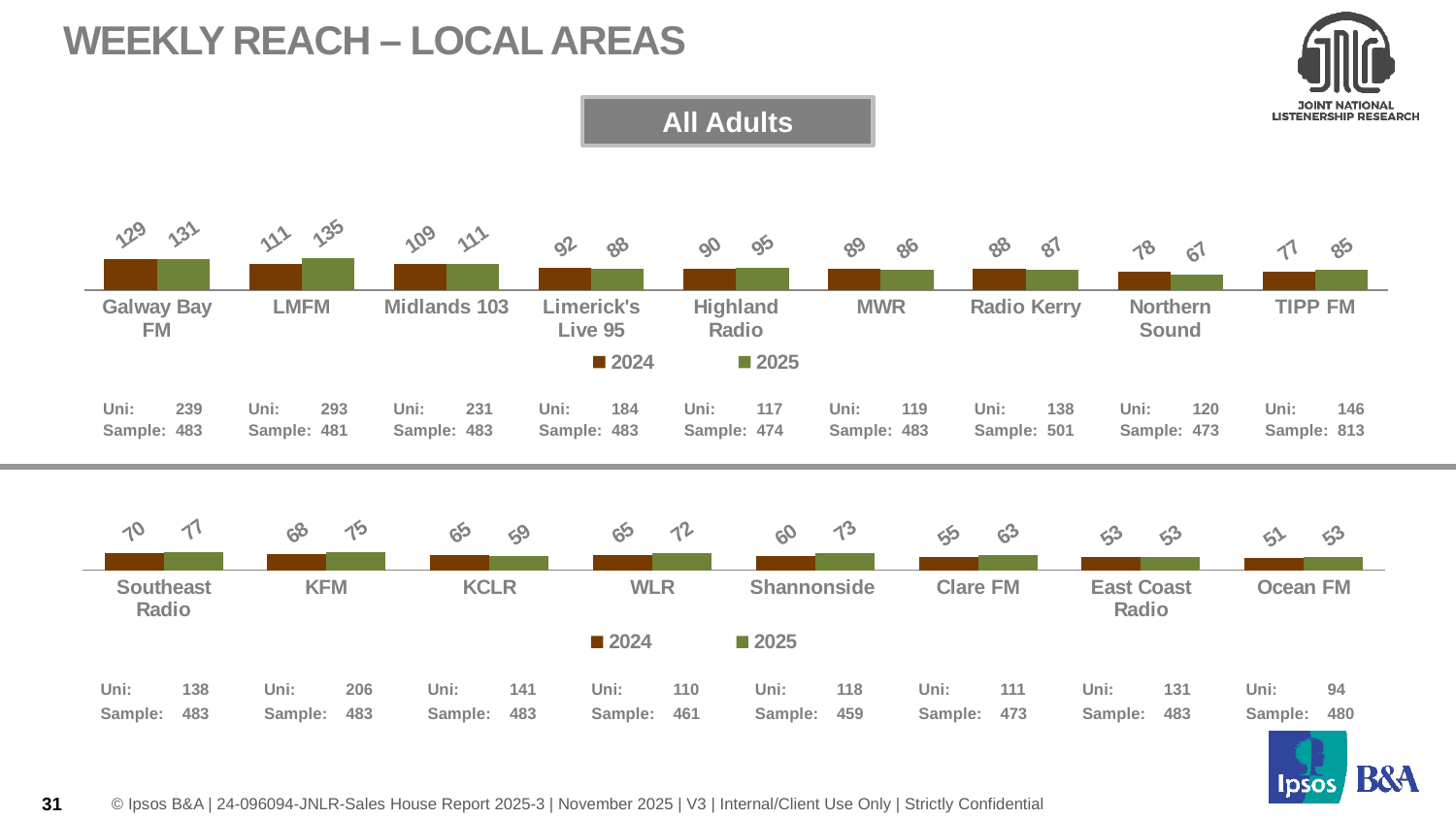
What type of chart is used on this slide? Bar chart In the top chart, what is the 2025 value for LMFM? 135 In the top chart, which station has the highest 2025 value? LMFM In the bottom chart, what is the 2025 value for Shannonside? 73 In the top chart, what is the difference between the 2024 and 2025 values for LMFM? 24 In the bottom chart, is the 2025 value for KCLR larger or smaller than its 2024 value? smaller In the bottom chart, which station has the highest 2024 value? Southeast Radio In the top chart, what is the 2024 value for Northern Sound? 78 In the top chart, which station has the lowest 2025 value? Northern Sound In the top chart, how many stations are shown? 9 In the bottom chart, which station has the lowest 2024 value? Ocean FM How many series does the legend of the bottom chart list? 2